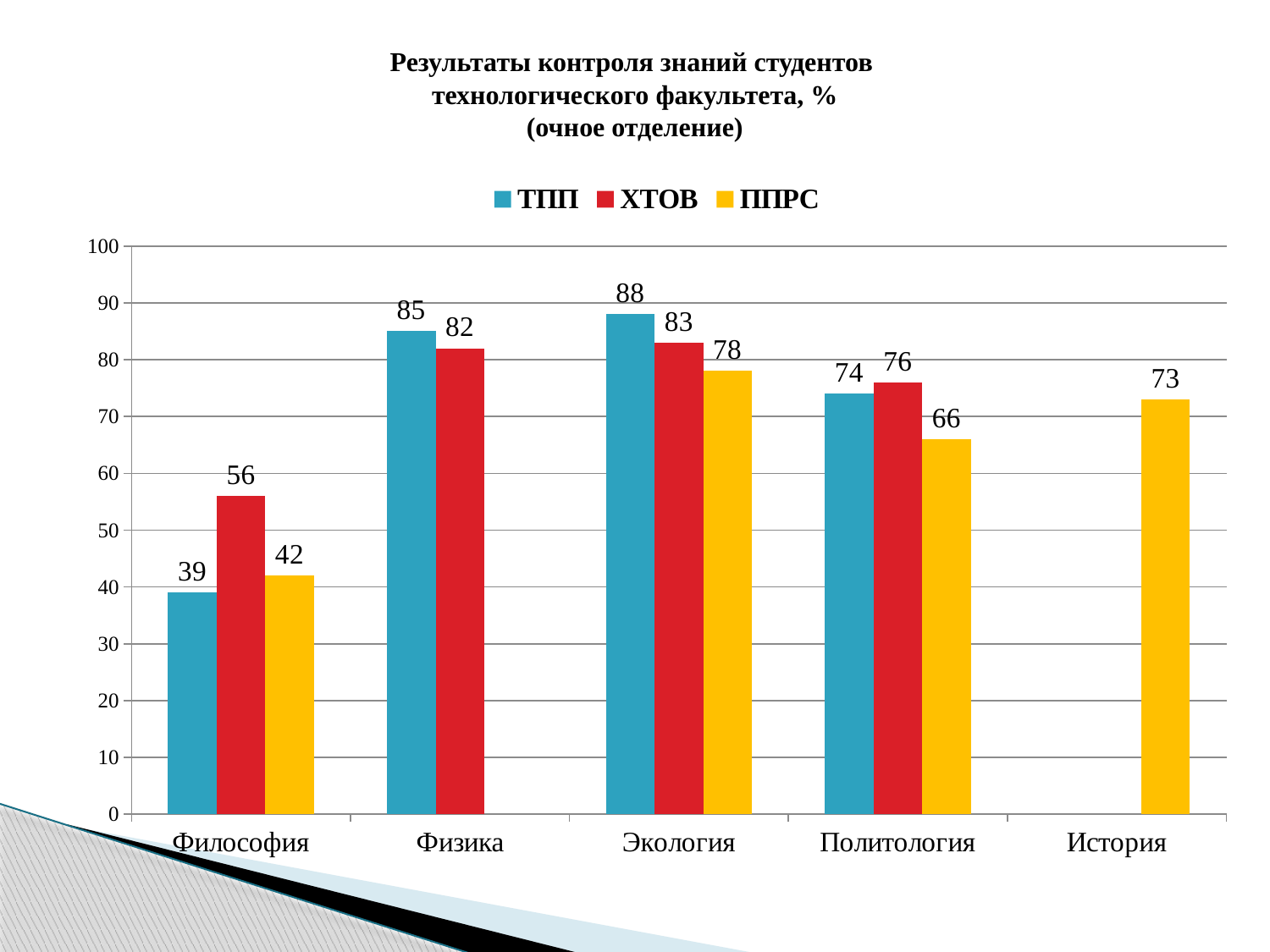
How many series does the legend list? 3 What kind of chart is shown on the slide? bar chart What is the value for ППРС in История? 73 What is the value for ХТОВ in Философия? 56 What is the difference between the ТПП and ППРС values in Политология? 8 Which is larger in Физика: ТПП or ХТОВ? ТПП Which category has the highest value for ТПП? Экология Which category has the lowest value for ППРС? Философия What is the value for ТПП in Экология? 88 Which series is shown in red? ХТОВ How many categories are shown on the x axis? 5 Is the value for ППРС in Политология greater or less than 70? less